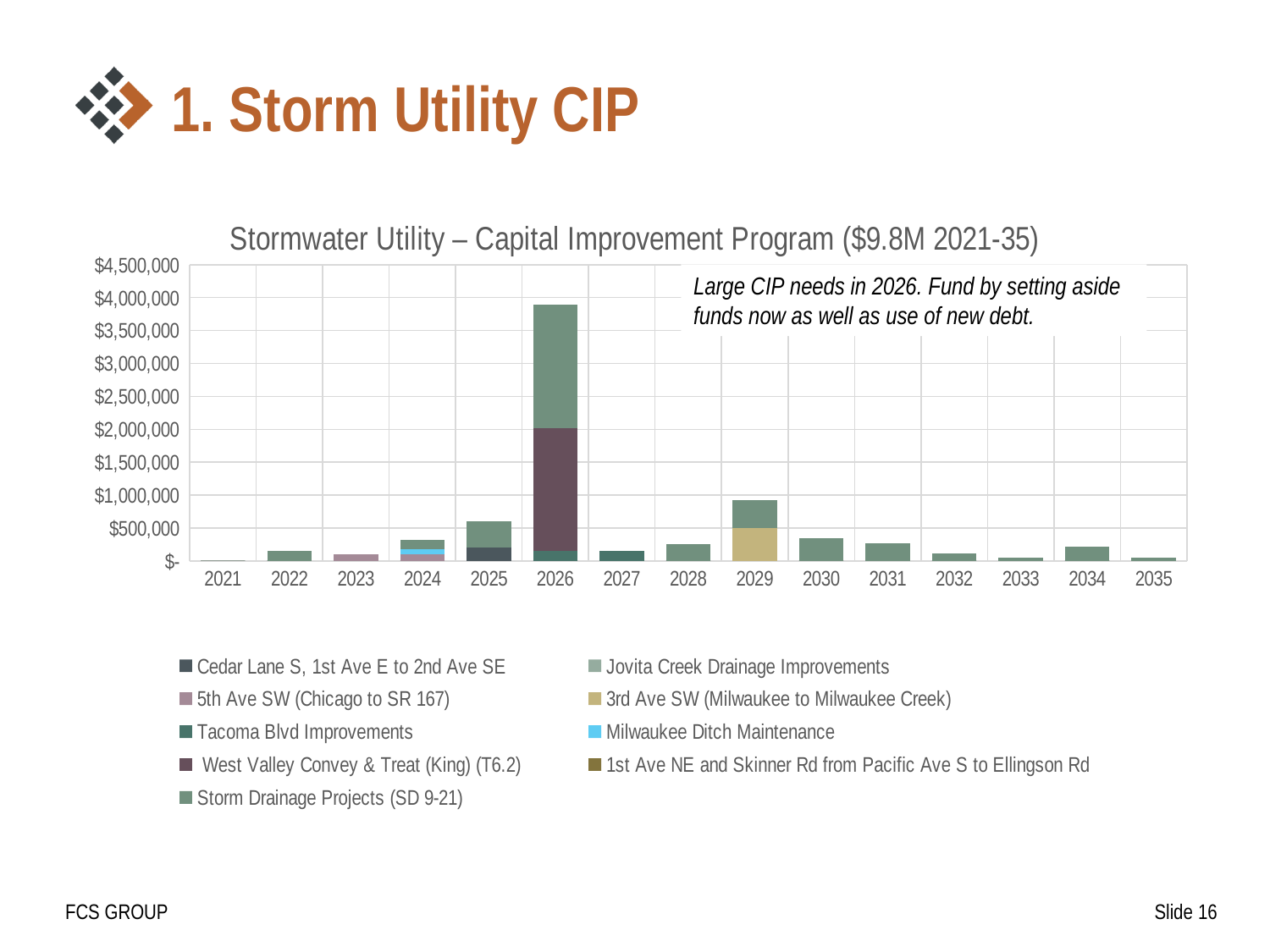
Which year has the lowest total capital improvement spending? 2021 Which year has a larger total, 2033 or 2034? 2034 What kind of chart is shown on the slide? Stacked bar chart Do the total values rise or fall from 2029 through 2033? fall Which year has the highest total capital improvement spending? 2026 Is the total value for 2026 greater or less than $3,500,000? greater How many years are shown along the x axis of the chart? 15 How many series does the chart legend list? 9 Is the total value for 2029 greater or less than $500,000? greater Which year has a larger total, 2029 or 2030? 2029 Is the total value for 2030 greater or less than $500,000? less What is the title of the chart? Stormwater Utility – Capital Improvement Program ($9.8M 2021-35)